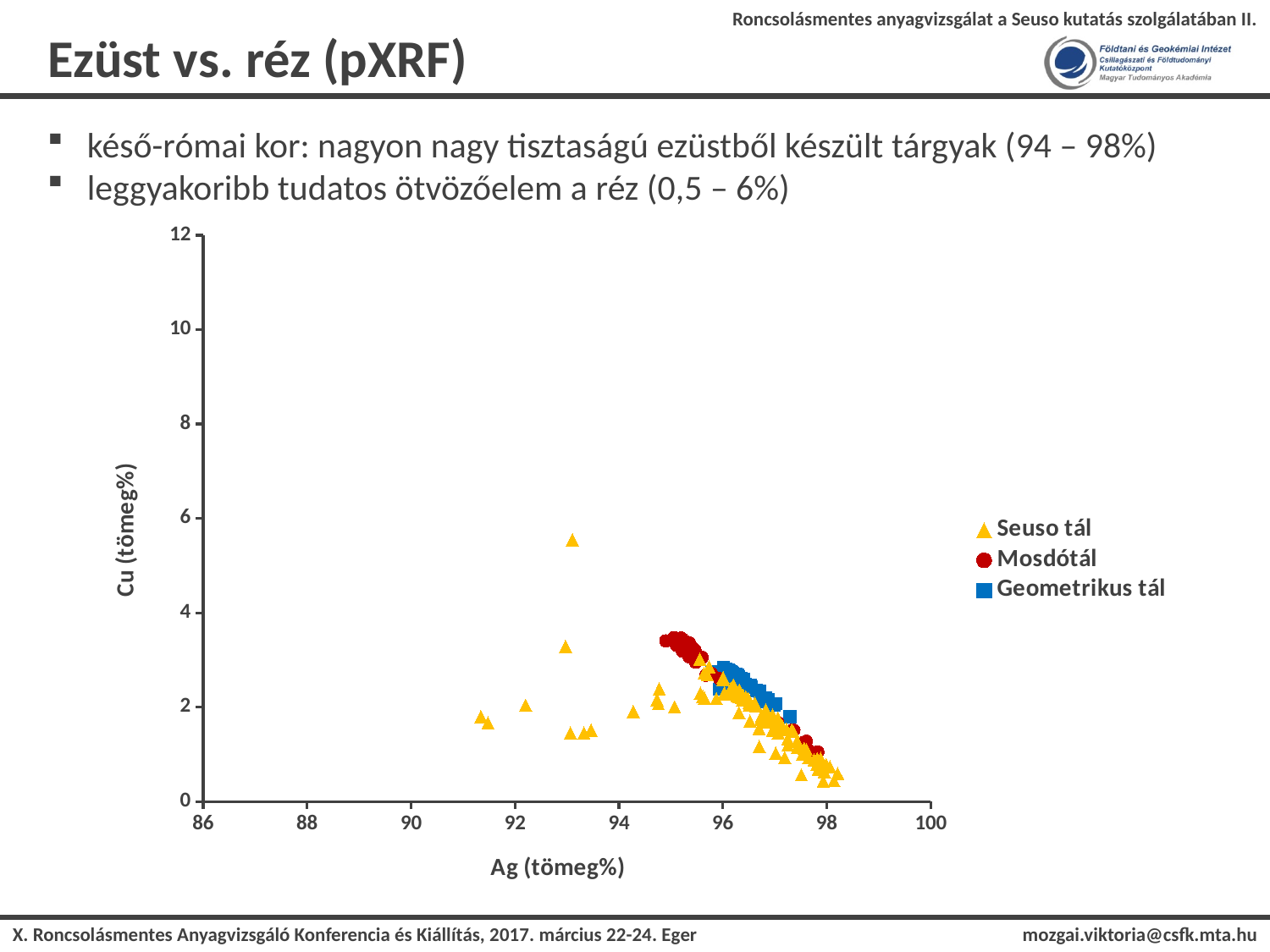
Is the highest Cu value of the Seuso tál series greater or less than 6? less Are the Cu values of the Mosdótál points greater or less than 4? less What kind of chart is shown on the slide? scatter chart Which series reaches the lowest Ag values? Seuso tál Are the Ag values of the Geometrikus tál points greater or less than 94? greater How many series does the legend list? 3 What are the three series named in the legend? Seuso tál, Mosdótál, Geometrikus tál Within the main cluster of points, does Cu rise or fall as Ag increases? fall Which series contains the point with the highest Cu value? Seuso tál Which series reaches the highest Ag values? Seuso tál What is the label of the x axis? Ag (tömeg%)